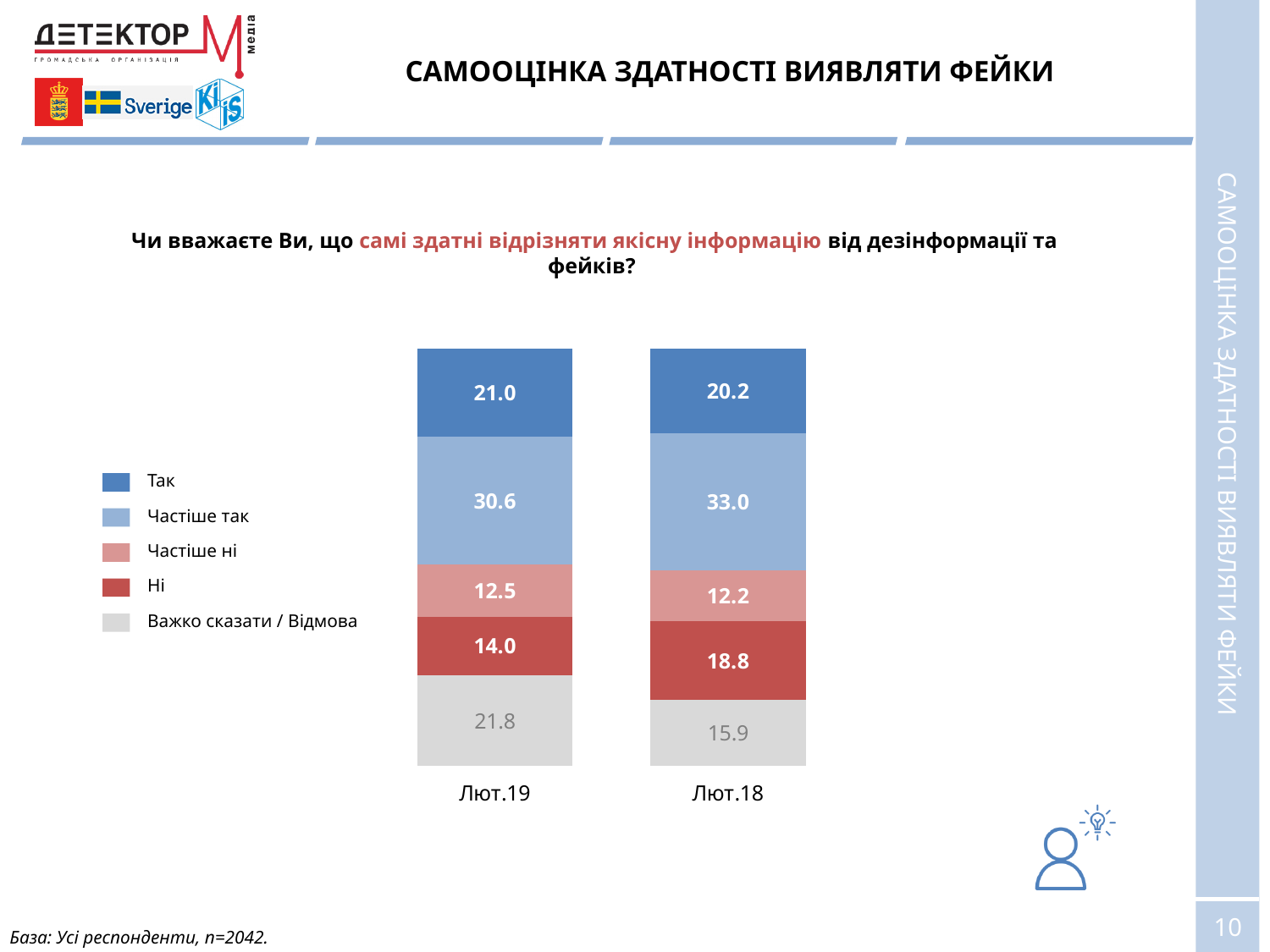
What is the value for "Важко сказати / Відмова" in Лют.19? 21.8 How many series does the legend list? 5 What type of chart is shown on the slide? Stacked bar chart What is the value for "Ні" in Лют.18? 18.8 What is the value for "Частіше так" in Лют.18? 33.0 How many bars (time points) are shown on the x axis? 2 Which response category has the highest value in Лют.19? Частіше так Which response category has the lowest value in Лют.18? Частіше ні Which is larger: "Частіше так" in Лют.19 or in Лют.18? Лют.18 What is the value for "Так" in Лют.19? 21.0 What is the difference between the "Ні" values for Лют.18 and Лют.19? 4.8 What is the total of the stacked bar for Лют.18? 100.1